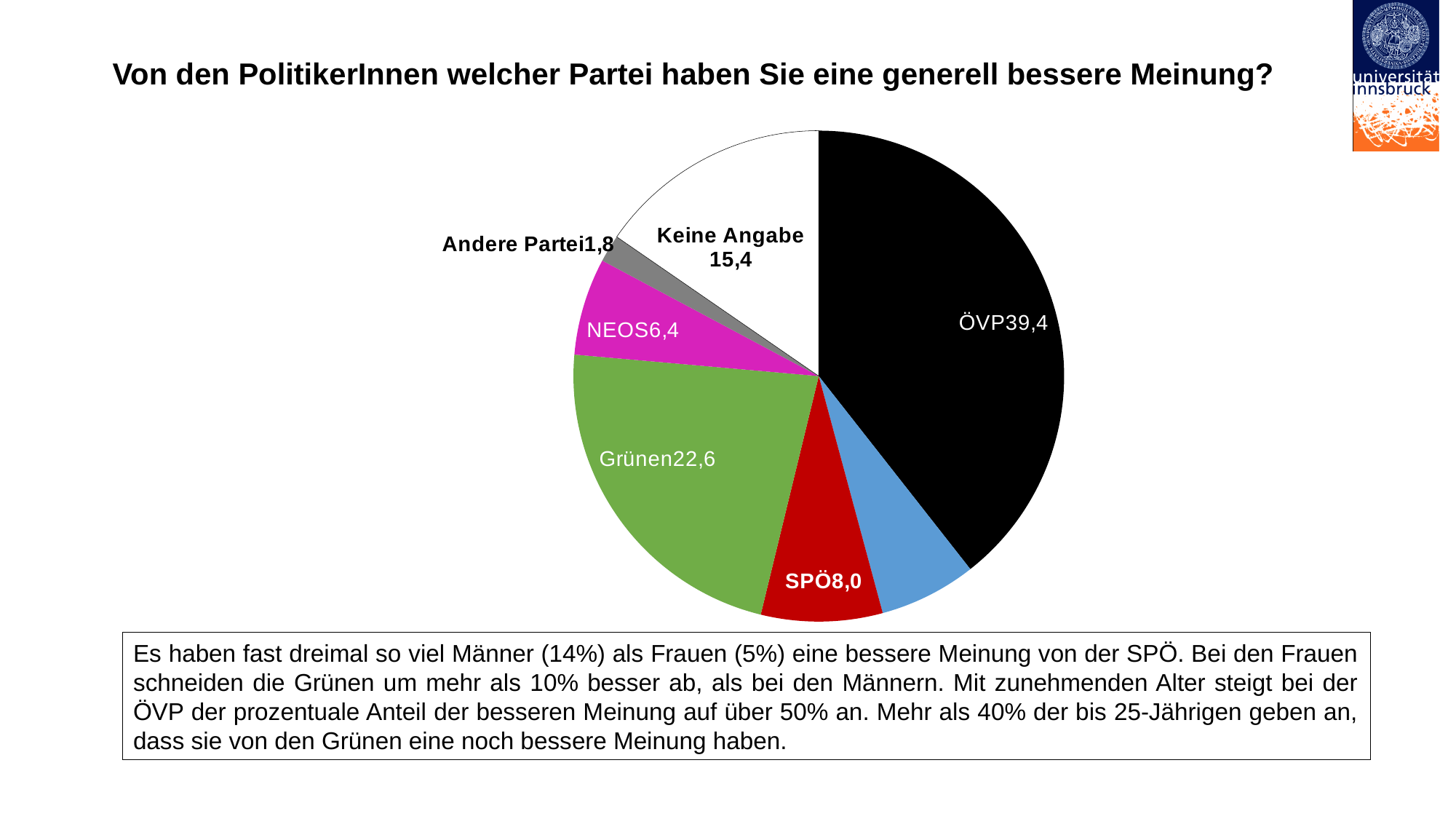
What colour is the ÖVP slice in the pie chart? black How many slices does the pie chart have? 7 What value is shown for Grünen in the pie chart? 22,6 What value is shown for ÖVP in the pie chart? 39,4 Which labelled slice of the pie chart has the largest value? ÖVP What value is shown for Andere Partei in the pie chart? 1,8 What kind of chart is shown on the slide? pie chart What is the difference between the values for ÖVP and Grünen? 16,8 Which labelled slice of the pie chart has the smallest value? Andere Partei What value is shown for NEOS in the pie chart? 6,4 What value is shown for Keine Angabe in the pie chart? 15,4 Which is larger, the value for Grünen or the value for Keine Angabe? Grünen